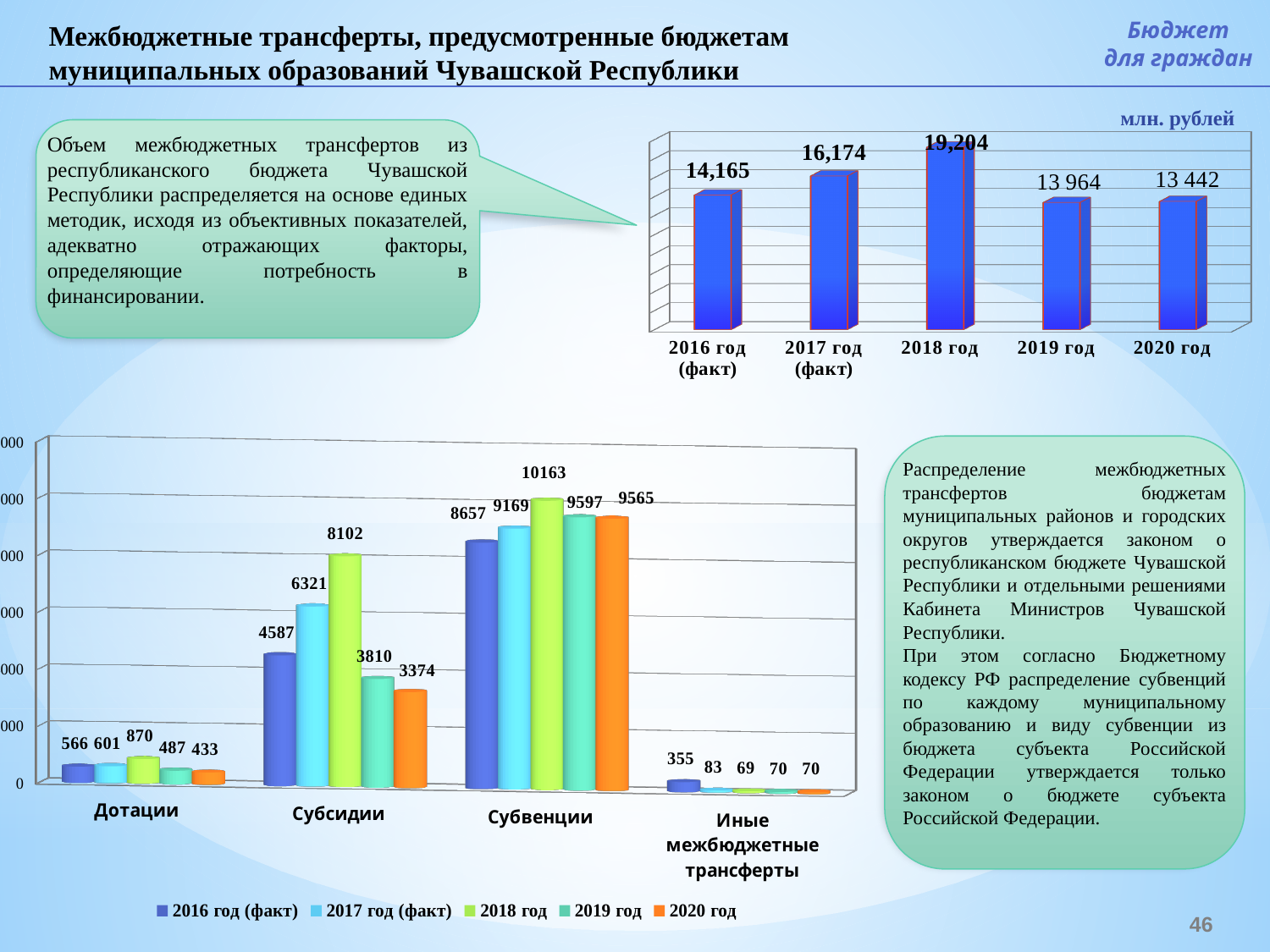
In the top-right chart, what is the difference between the values for 2017 год (факт) and 2016 год (факт)? 2,009 In the bottom-left chart, what is the value for Субсидии in 2020 год? 3374 In the top-right chart, which year has the lowest value? 2020 год In the bottom-left chart, which category has the highest value in 2019 год? Субвенции In the top-right chart, how many years are shown? 5 What kind of chart is the bottom-left chart? Bar chart In the bottom-left chart, which is larger for Дотации: the value for 2018 год or the value for 2019 год? 2018 год In the bottom-left chart, what is the value for Субвенции in 2018 год? 10163 In the top-right chart, what is the value for 2018 год? 19,204 In the bottom-left chart, what is the difference between the 2018 год and 2016 год (факт) values for Субсидии? 3515 In the bottom-left chart, how many series does the legend list? 5 In the top-right chart, which year has the highest value? 2018 год